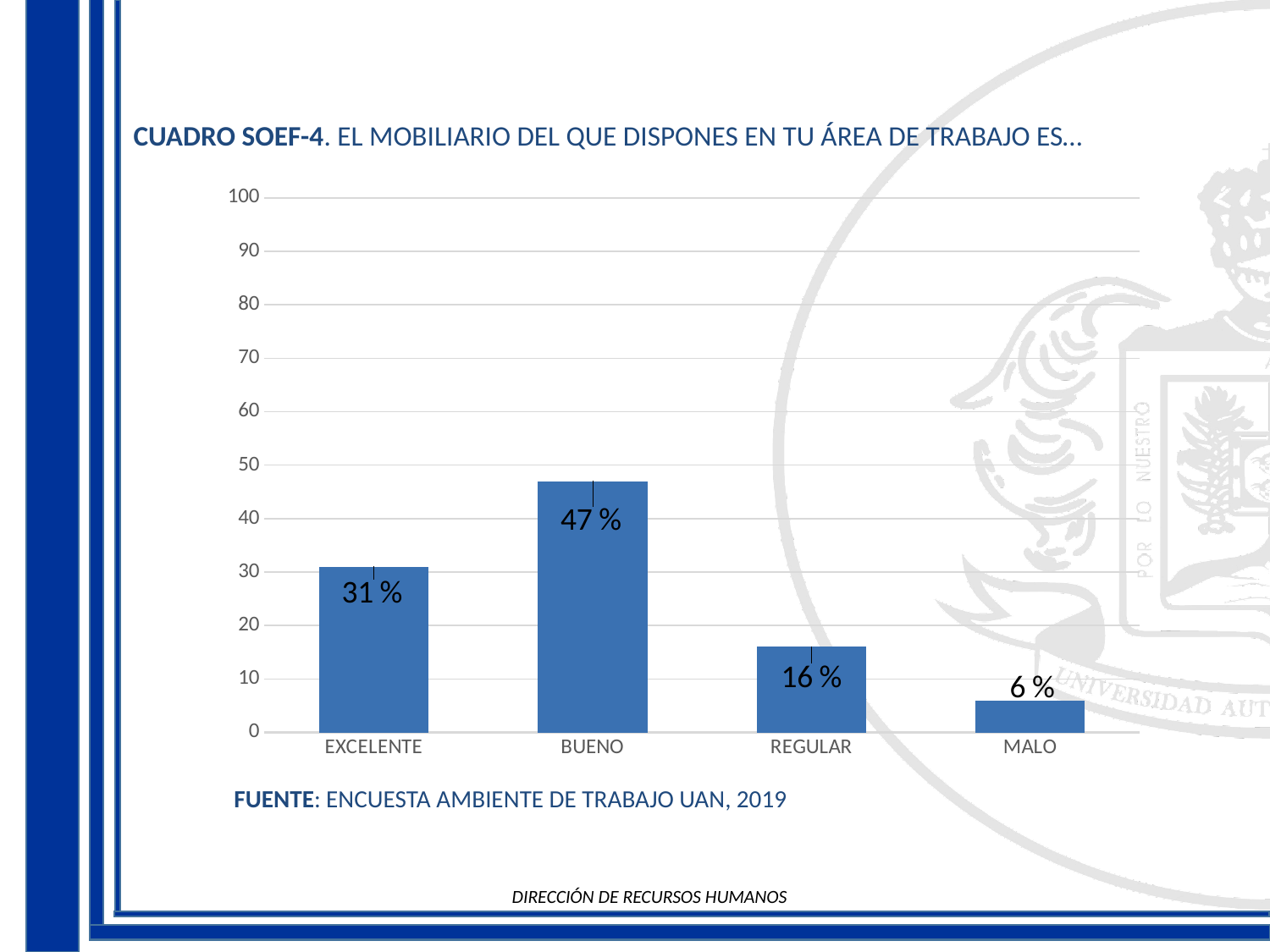
What is the difference between the values for BUENO and EXCELENTE? 16 % What source is cited below the chart? ENCUESTA AMBIENTE DE TRABAJO UAN, 2019 What is the value for BUENO? 47 % Which category has the lowest value? MALO What is the value for REGULAR? 16 % Is the value for BUENO greater or less than 50? less Which is larger, the value for REGULAR or the value for MALO? REGULAR Which category has the highest value? BUENO What is the value for MALO? 6 % What is the value for EXCELENTE? 31 % How many categories are shown on the x axis? 4 What kind of chart is shown on the slide? bar chart